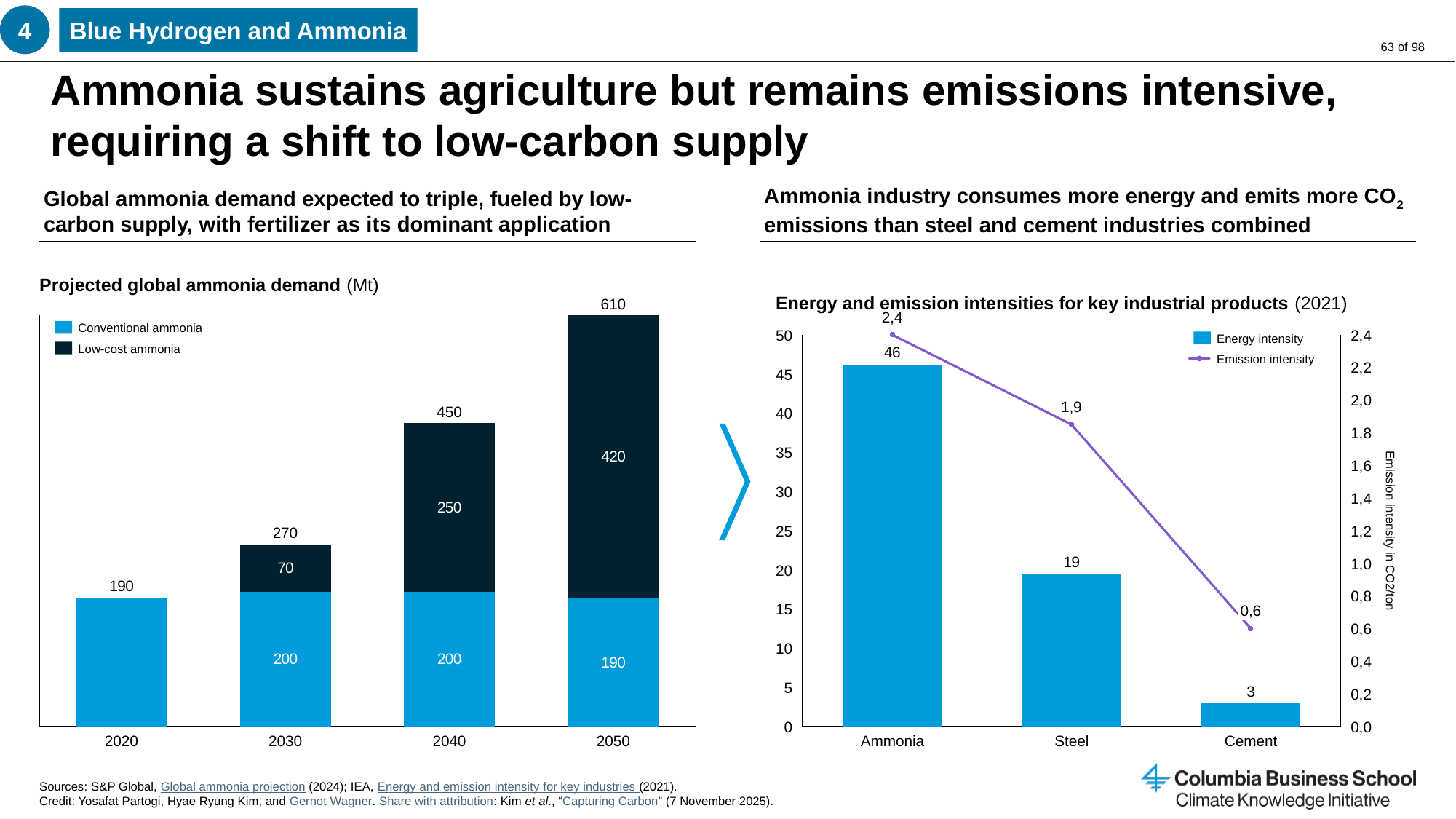
In the 'Energy and emission intensities for key industrial products' chart, what is the energy intensity for Steel? 19 In the 'Projected global ammonia demand' chart, how much higher is the total for 2050 than the total for 2040? 160 In the 'Projected global ammonia demand' chart, what is the total demand shown for 2050? 610 In the 'Projected global ammonia demand' chart, what is the conventional ammonia value for 2030? 200 In the 'Energy and emission intensities for key industrial products' chart, what is the difference in energy intensity between Ammonia and Steel? 27 In the 'Projected global ammonia demand' chart, do the total values rise or fall from 2020 to 2050? rise In the 'Energy and emission intensities for key industrial products' chart, which product has the highest energy intensity? Ammonia In the 'Projected global ammonia demand' chart, which year has the lowest total demand? 2020 In the 'Projected global ammonia demand' chart, what is the low-cost ammonia value for 2040? 250 In the 'Energy and emission intensities for key industrial products' chart, what is the emission intensity for Cement? 0,6 In the 'Energy and emission intensities for key industrial products' chart, how many products are shown on the x axis? 3 In the 'Projected global ammonia demand' chart, how many series does the legend list? 2